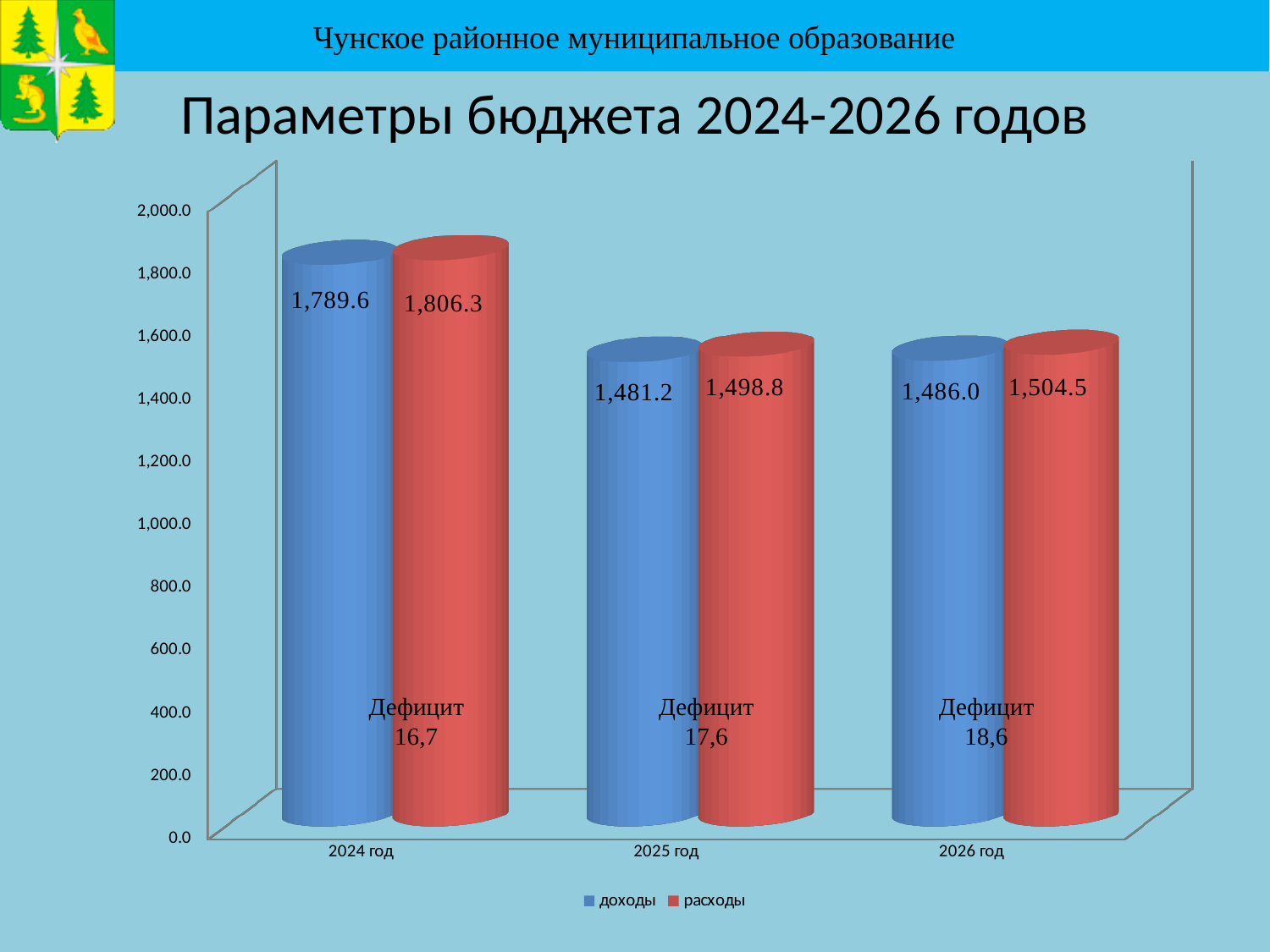
What is the difference between расходы and доходы in 2024 год? 16.7 What is the value of доходы for 2024 год? 1,789.6 In which year are доходы the highest? 2024 год What is the value of расходы for 2025 год? 1,498.8 Which is larger in 2026 год, доходы or расходы? расходы What kind of chart is shown on the slide? bar chart In which year are расходы the lowest? 2025 год How many series does the legend list? 2 How many years are shown on the x axis? 3 What is the title of the chart? Параметры бюджета 2024-2026 годов What is the value of расходы for 2026 год? 1,504.5 Is the value of доходы for 2025 год greater or less than 1,400.0? greater